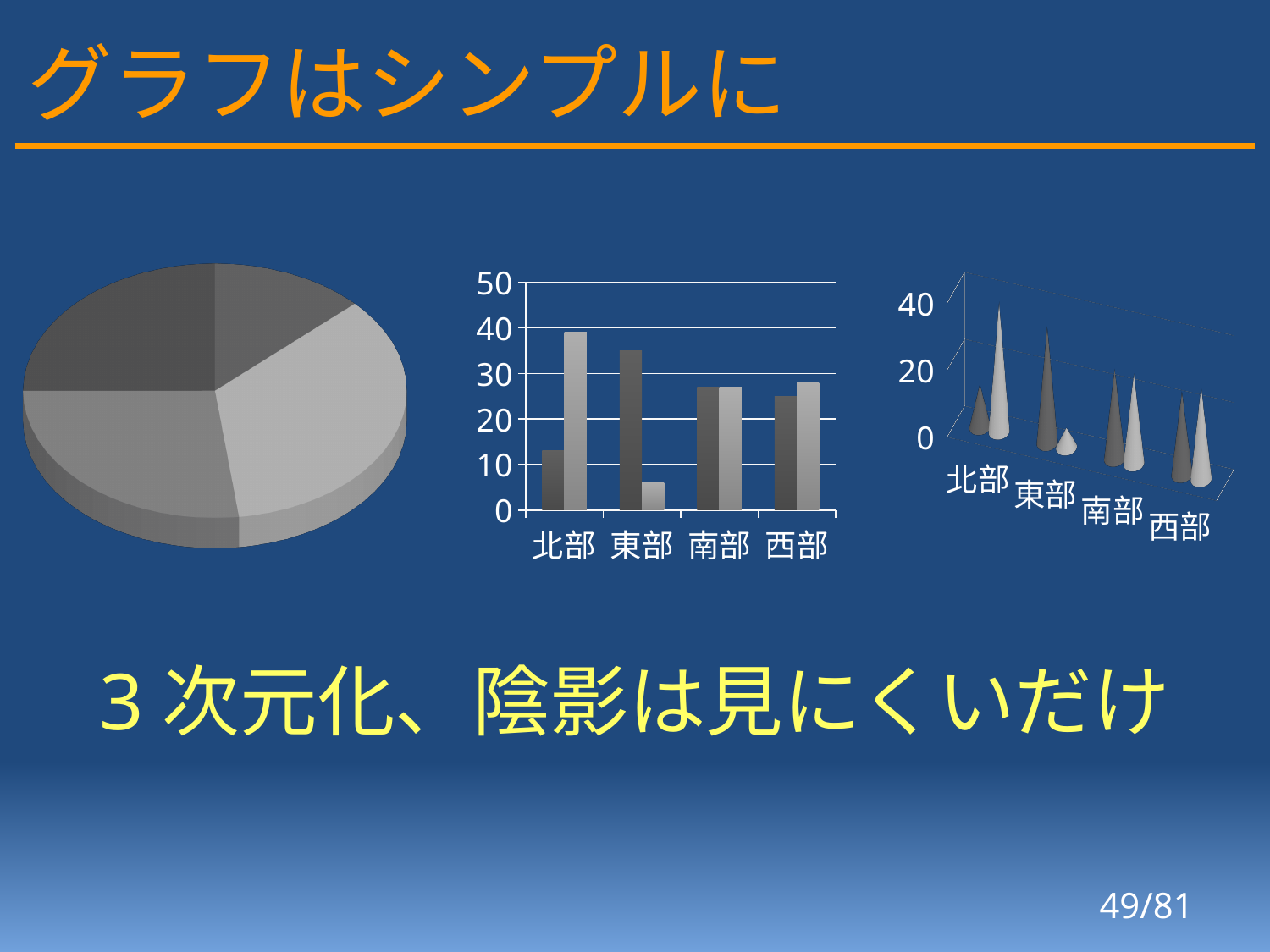
In the middle bar chart, which category has the shortest bar? 東部 In the middle bar chart, is the value of the light bar for 東部 greater or less than 10? less How many categories are shown on the x axis of the middle bar chart? 4 In the middle bar chart, is the value of the light bar for 北部 greater or less than 30? greater How many slices does the pie chart on the left have? 4 In the middle bar chart, is the value of the dark bar for 東部 greater or less than 30? greater How many bars are drawn for each category in the middle bar chart? 2 In the middle bar chart, which is larger: the dark bar for 北部 or the dark bar for 東部? 東部 What kind of chart is the chart in the middle of the slide? bar chart What kind of chart is the chart on the left of the slide? pie chart